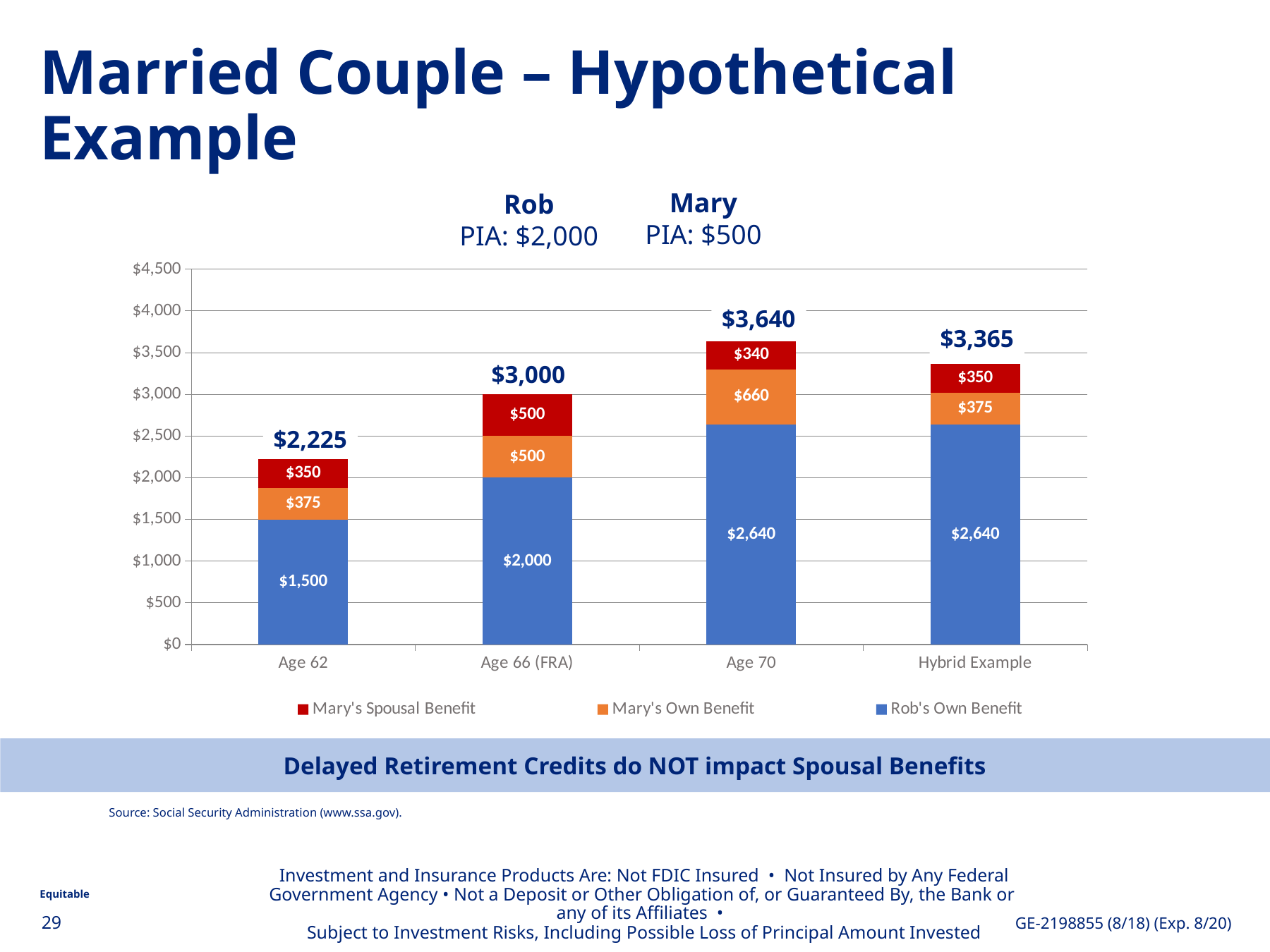
Which category has the lowest total benefit? Age 62 How many series does the legend list? 3 Which category has the highest total benefit? Age 70 What is Mary's Own Benefit at Age 70? $660 Which series is shown in blue in the legend? Rob's Own Benefit What is the total of the stacked bar for Age 70? $3,640 How many categories are shown on the x axis? 4 Is Rob's Own Benefit larger at Age 62 or at Age 66 (FRA)? Age 66 (FRA) What is Mary's Spousal Benefit in the Hybrid Example? $350 What kind of chart is shown on the slide? Stacked bar chart What is the difference between the total for Age 70 and the total for the Hybrid Example? $275 What is Rob's Own Benefit at Age 66 (FRA)? $2,000